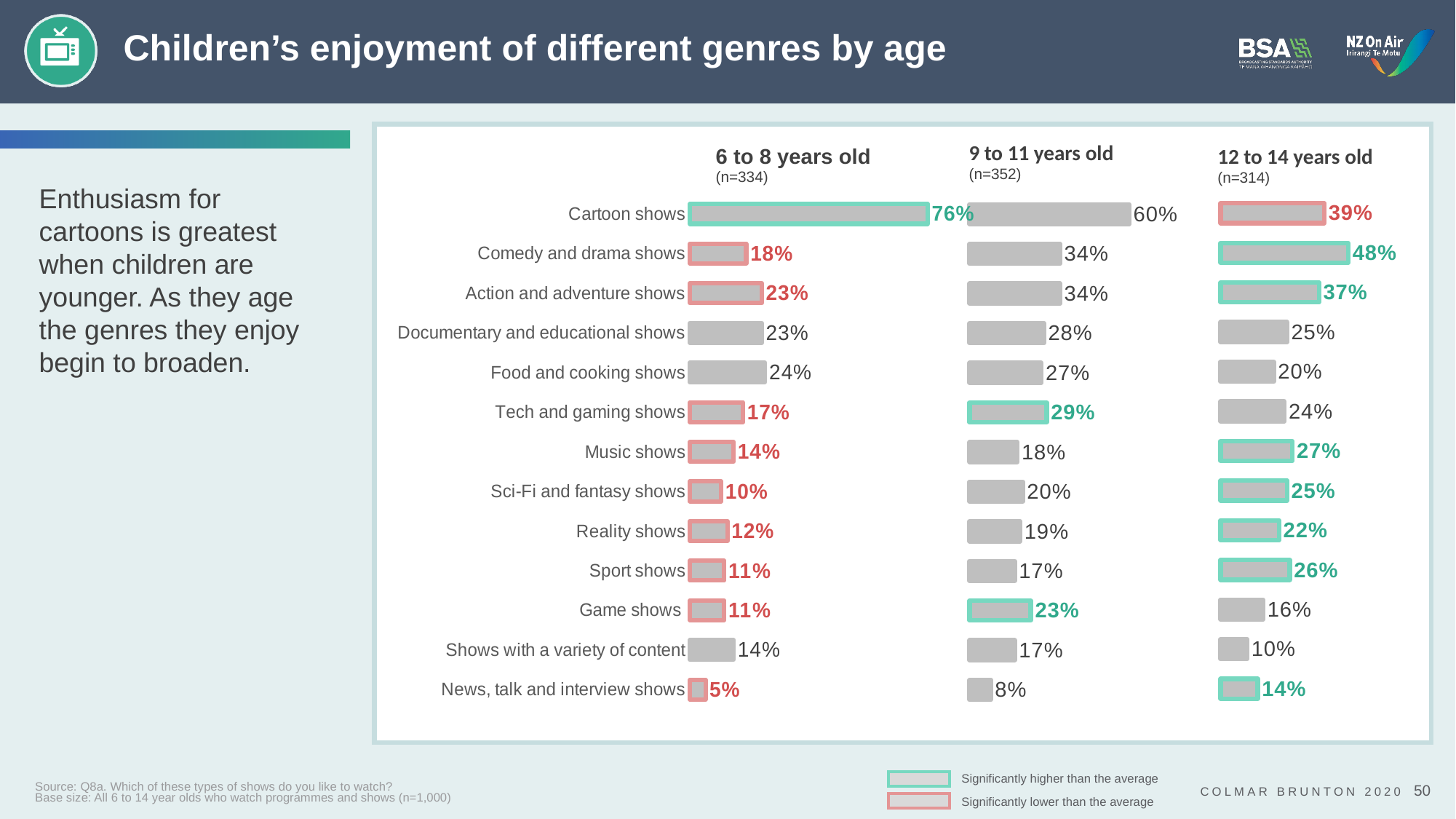
In the 12 to 14 years old chart, which genre has the lowest value? Shows with a variety of content In the 9 to 11 years old chart, which is larger: Game shows or Sport shows? Game shows In the 12 to 14 years old chart, what is the value for Comedy and drama shows? 48% In the 9 to 11 years old chart, which genre has the highest value? Cartoon shows In the 9 to 11 years old chart, what is the value for Tech and gaming shows? 29% How many genres are listed in the 6 to 8 years old chart? 13 In the 6 to 8 years old chart, which genre has the lowest value? News, talk and interview shows What type of chart is used to show children's enjoyment of genres by age? Bar chart According to the legend, what does a green outline on a bar indicate? Significantly higher than the average What is the difference between the Cartoon shows value in the 6 to 8 years old chart and in the 12 to 14 years old chart? 37 percentage points In the 6 to 8 years old chart, what percentage of children enjoy Cartoon shows? 76% What is the base size (n) shown for the 9 to 11 years old chart? n=352